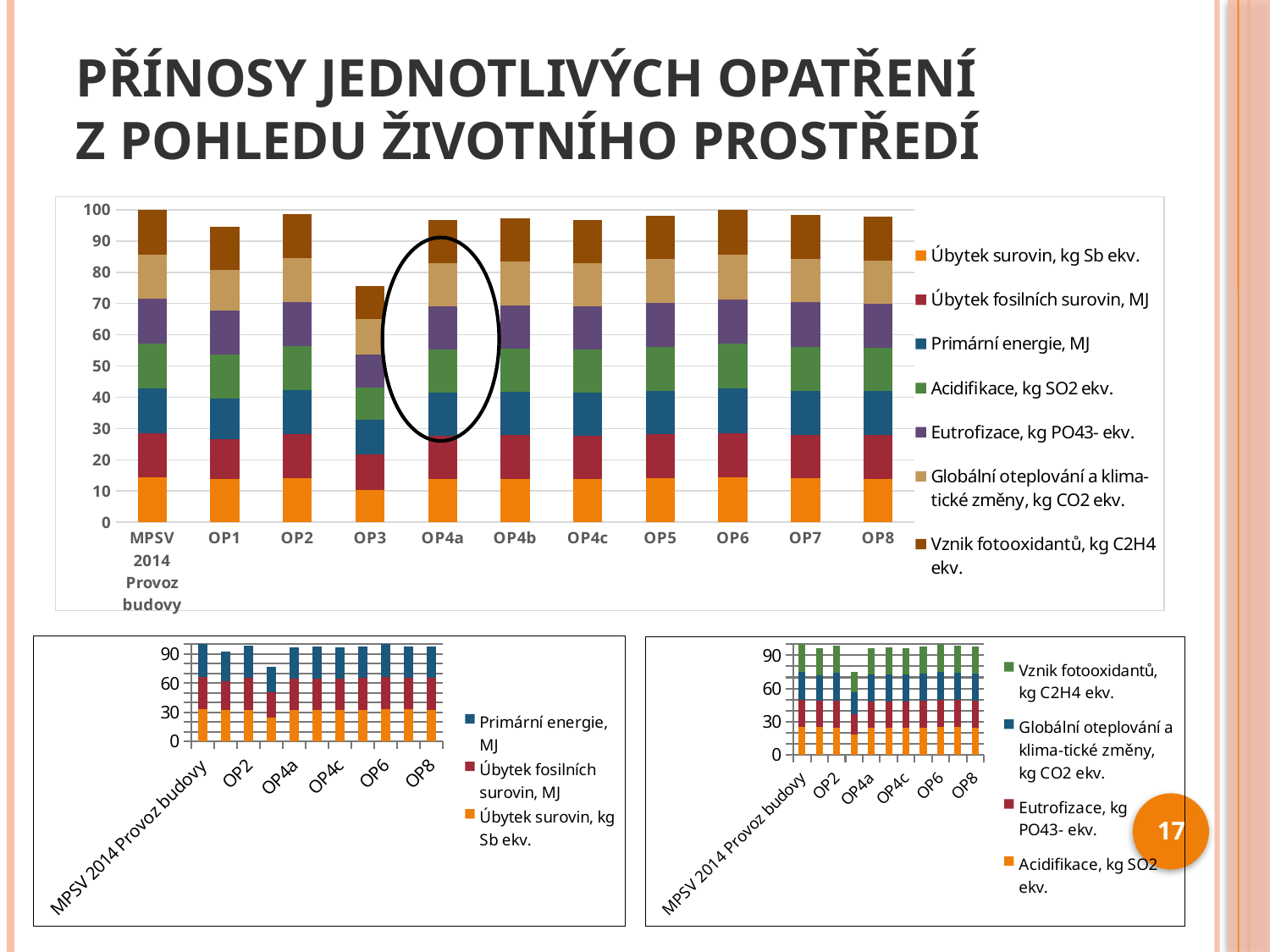
In the top chart, how many series does the legend list? 7 What kind of chart is the bottom-right chart? stacked bar chart In the top chart, what colour represents the series Primární energie, MJ? blue In the bottom-left chart, how many series does the legend list? 3 In the top chart, which has the larger total stacked value, OP3 or OP5? OP5 In the top chart, is the total value for OP3 greater or less than 80? less In the top chart, which series is plotted at the bottom of each stacked bar? Úbytek surovin, kg Sb ekv. In the top chart, how many categories are shown on the x axis? 11 What kind of chart is the large chart at the top of the slide? stacked bar chart In the bottom-right chart, how many series does the legend list? 4 In the top chart, which category has the lowest total stacked value? OP3 In the top chart, is the total value for OP4a greater or less than 90? greater